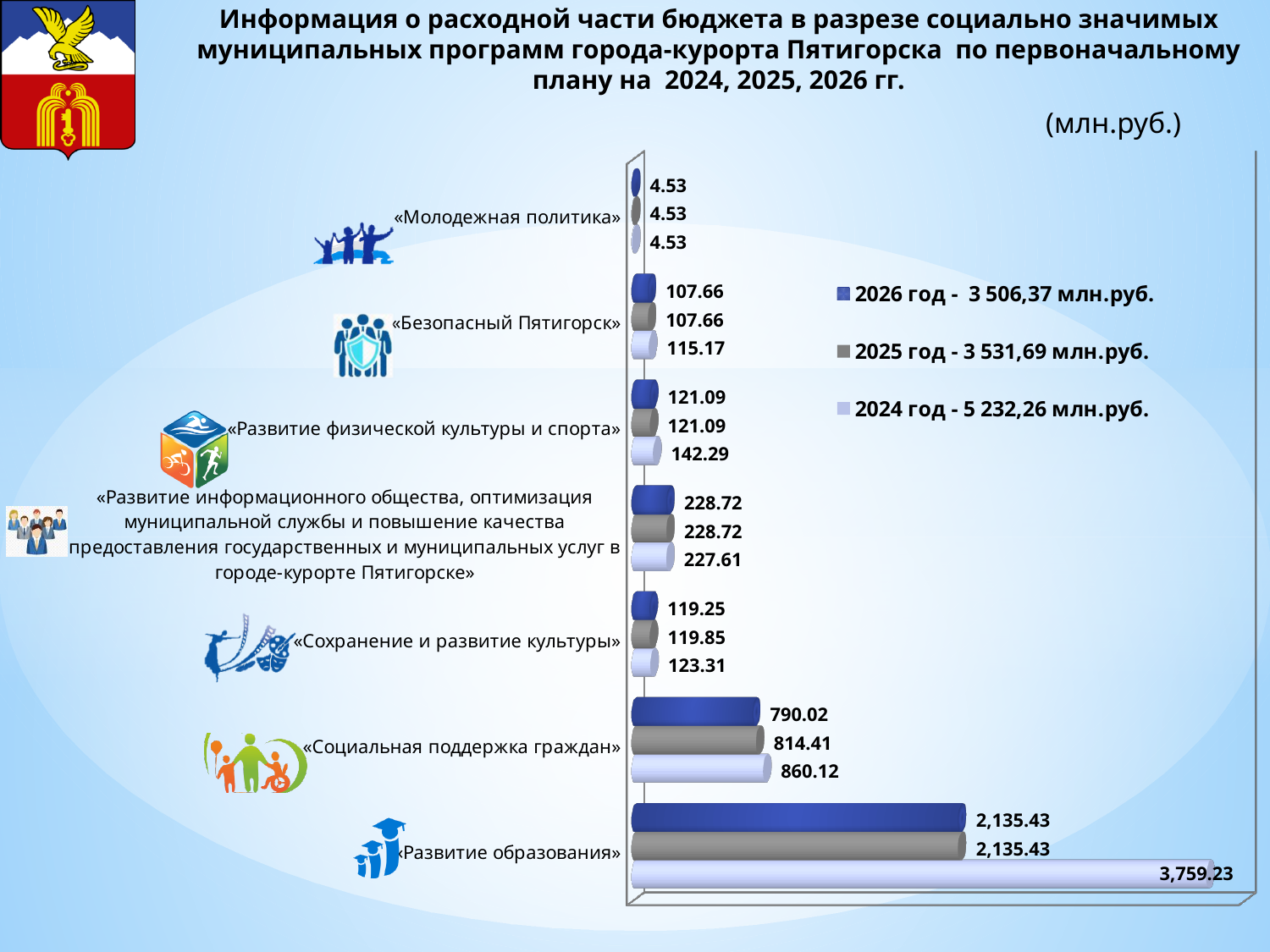
What is the value for «Сохранение и развитие культуры» in the 2025 год series? 119.85 What is the difference between the 2024 год and 2026 год values for «Развитие образования»? 1,623.80 How many programs (categories) are shown in the chart? 7 What is the value for «Развитие образования» in the 2026 год series? 2,135.43 What is the difference between the 2024 год and 2025 год values for «Социальная поддержка граждан»? 45.71 Which program has the lowest value in the 2026 год series? «Молодежная политика» How many series does the legend list? 3 Which is larger for «Развитие физической культуры и спорта»: the 2024 год value or the 2026 год value? 2024 год What is the value for «Безопасный Пятигорск» in the 2024 год series? 115.17 What is the value for «Социальная поддержка граждан» in the 2024 год series? 860.12 What kind of chart is shown on the slide? Bar chart Which program has the highest value in the 2024 год series? «Развитие образования»